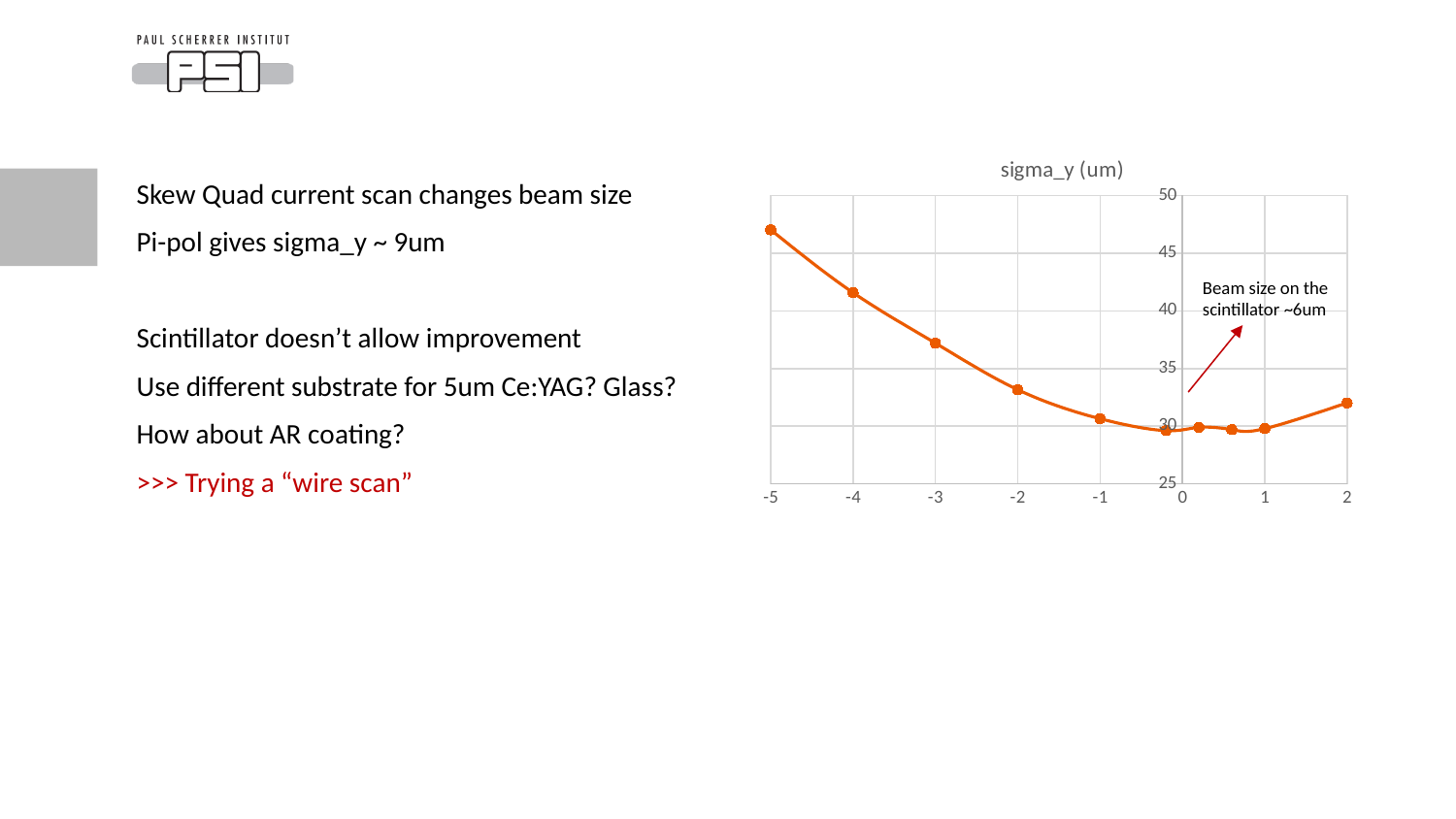
Is the value at x = -3 greater or less than 40? less What is the title of the chart? sigma_y (um) Is the value at x = -5 greater or less than 45? greater Which has the larger sigma_y value, x = -5 or x = 2? x = -5 What kind of chart is shown on the slide? line chart Do the values rise or fall as x goes from -5 to -1? fall At which x value is the plotted sigma_y highest? -5 Is the value at x = 2 greater or less than 30? greater Which has the larger sigma_y value, x = -4 or x = -3? x = -4 What does the annotation with the red arrow on the chart say? Beam size on the scintillator ~6um